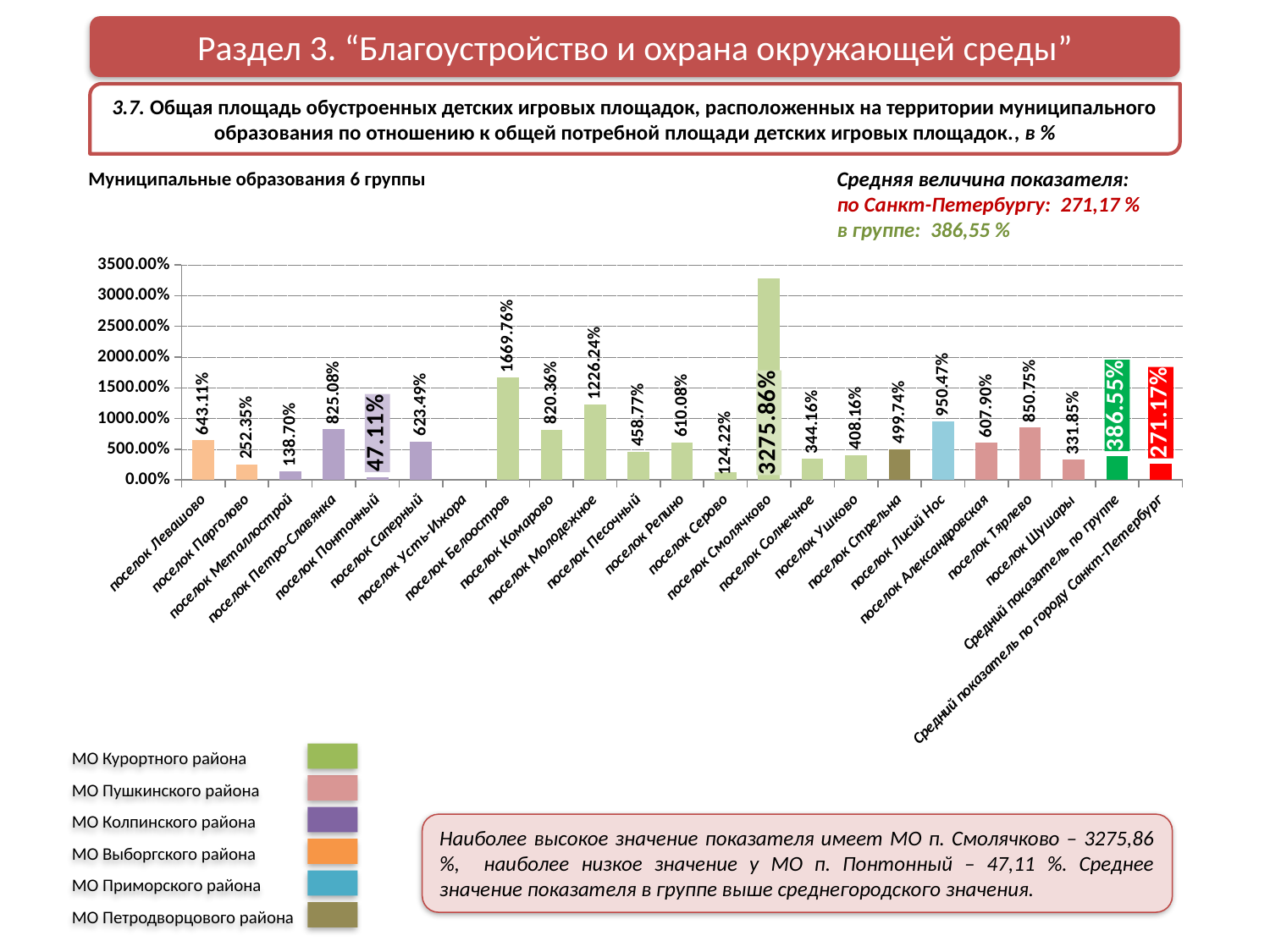
Which category has the lowest labelled value? поселок Понтонный Is the value for поселок Петро-Славянка greater or less than 500.00%? greater Which category has the highest value? поселок Смолячково What kind of chart is shown on the slide? bar chart What is the value for поселок Белоостров? 1669.76% What is the value for поселок Понтонный? 47.11% What is the value for поселок Смолячково? 3275.86% What is the value shown for Средний показатель по городу Санкт-Петербург? 271.17% Which colour in the legend represents МО Курортного района? green What is the difference between the values for поселок Молодежное and поселок Комарово? 405.88% Which is larger, the value for поселок Лисий Нос or the value for поселок Тярлево? поселок Лисий Нос What is the value shown for Средний показатель по группе? 386.55%